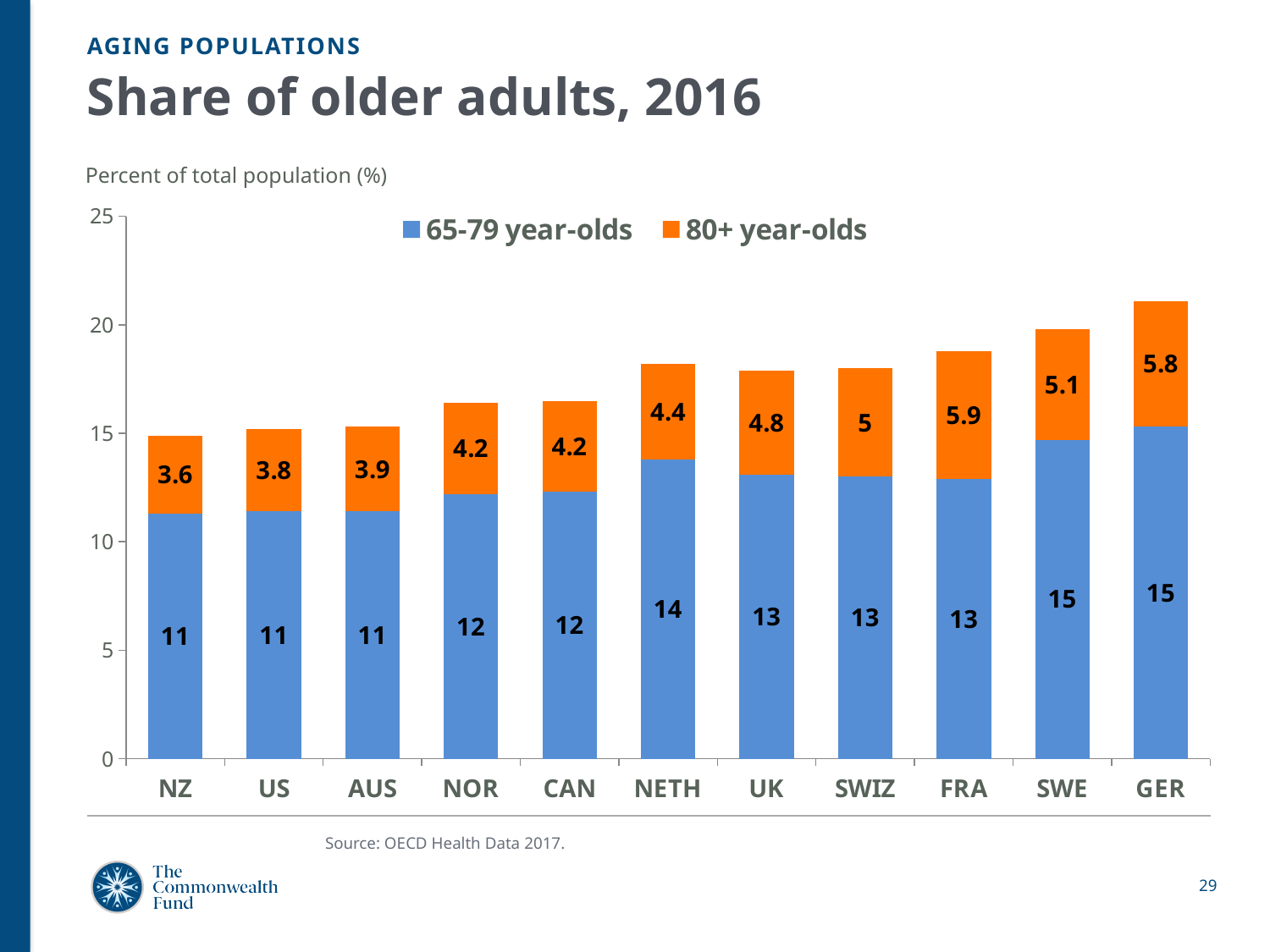
How many series does the legend list? 2 Which country has the highest value for 80+ year-olds? FRA Which is larger, the 80+ year-olds value for Switzerland (SWIZ) or for Norway (NOR)? SWIZ What is the value for 80+ year-olds in the UK? 4.8 Which colour represents the 80+ year-olds series? Orange Which country has the lowest value for 80+ year-olds? NZ What is the value for 80+ year-olds in Germany (GER)? 5.8 Is the total stacked bar for Germany (GER) greater or less than 20? greater What is the difference between the 80+ year-olds values for France (FRA) and New Zealand (NZ)? 2.3 How many countries are shown on the x axis? 11 What kind of chart is shown on the slide? Stacked bar chart What is the value for 65-79 year-olds in the Netherlands (NETH)? 14